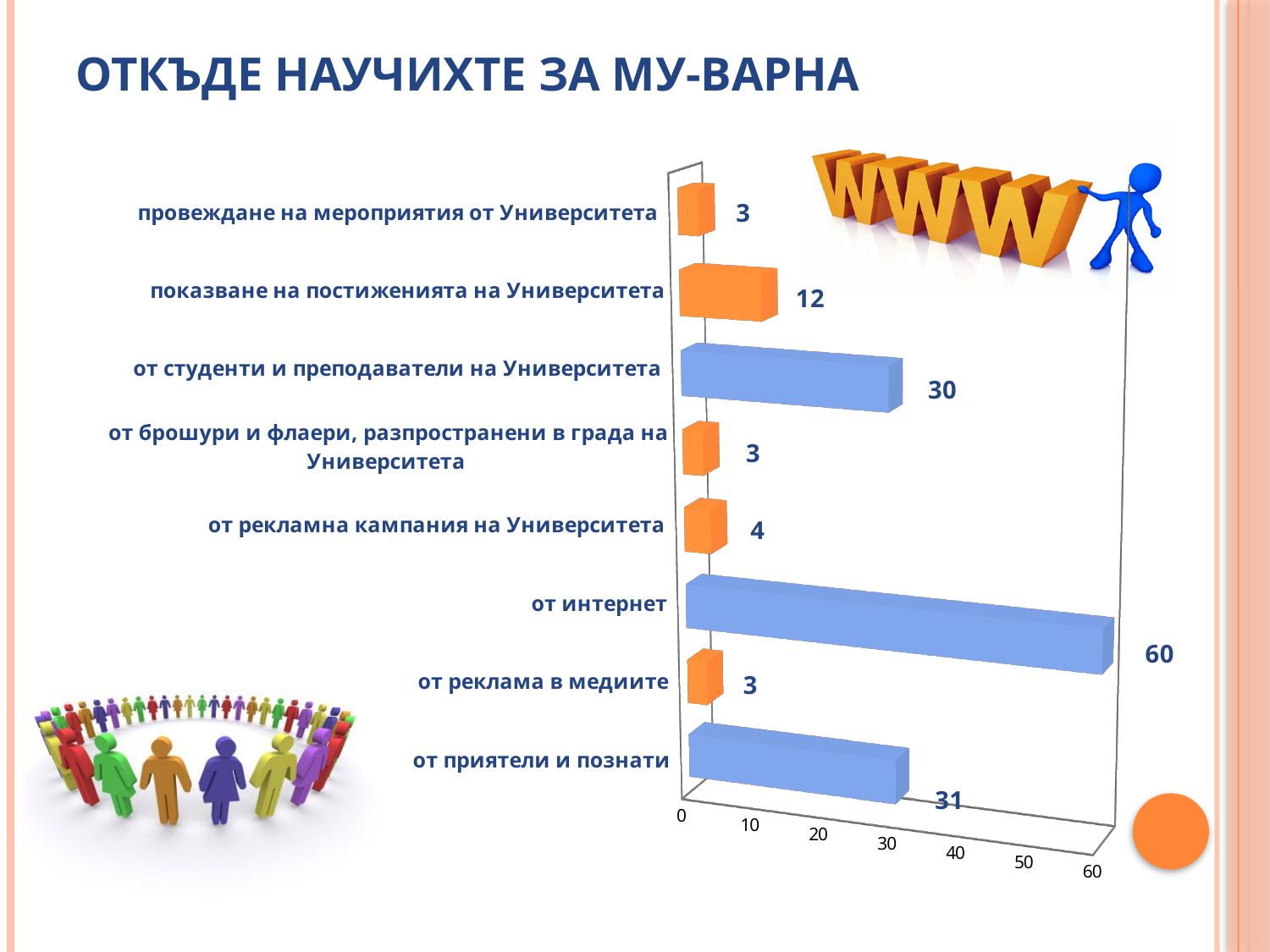
How many categories are shown in the chart? 8 How many categories have a value of 3? 3 What is the value for "показване на постиженията на Университета"? 12 What is the title of the slide? ОТКЪДЕ НАУЧИХТЕ ЗА МУ-ВАРНА What is the difference between the values for "от интернет" and "от приятели и познати"? 29 What kind of chart is shown on the slide? bar chart What is the value for "от интернет"? 60 What is the value for "от приятели и познати"? 31 What is the value for "от студенти и преподаватели на Университета"? 30 What is the value for "от рекламна кампания на Университета"? 4 Which is larger, the value for "от приятели и познати" or the value for "от студенти и преподаватели на Университета"? от приятели и познати Which category has the highest value? от интернет